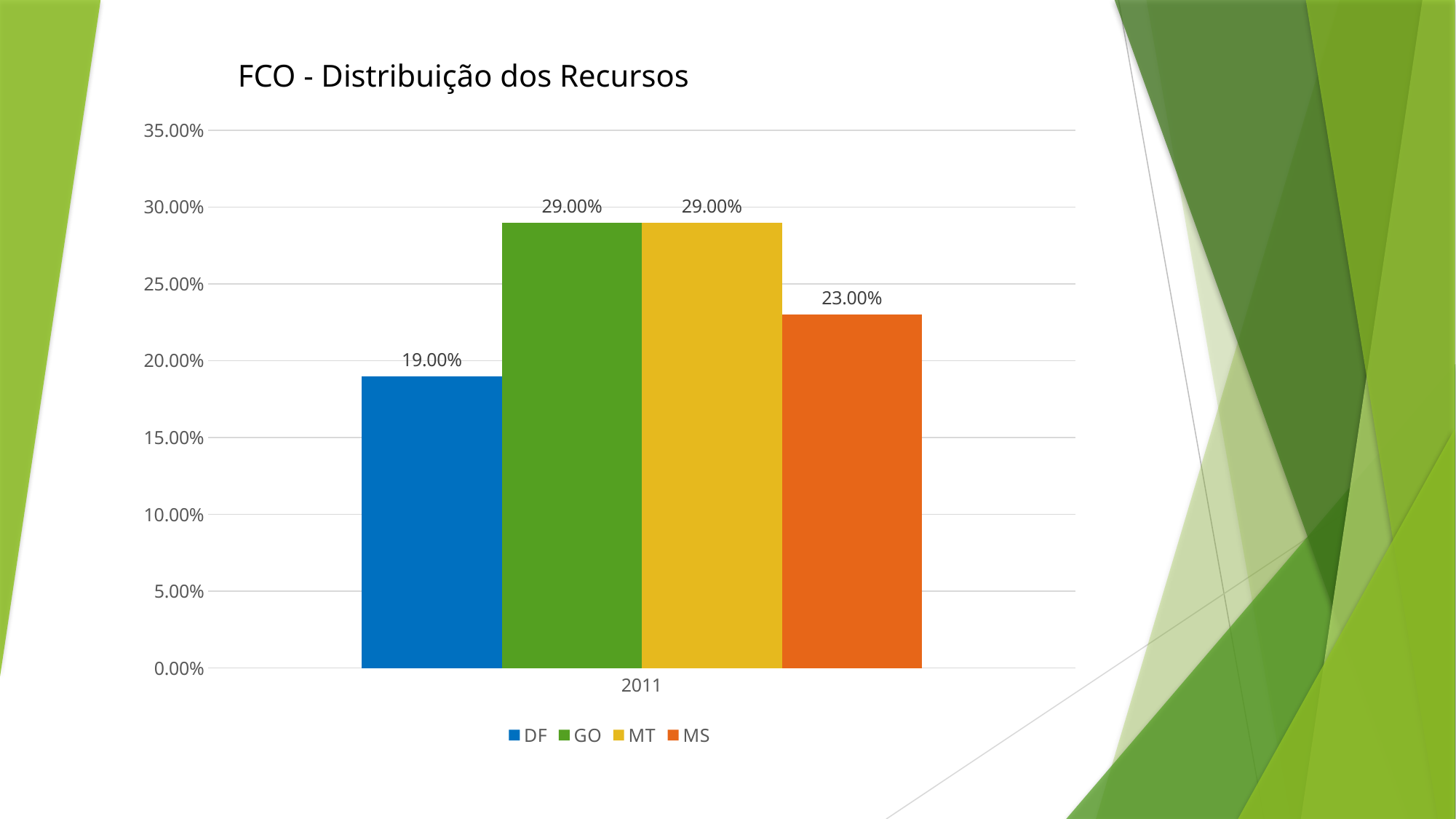
What colour is the bar for MT? yellow How many series does the legend list? 4 What is the difference between the values for MS and DF? 4.00% What is the value for MS in 2011? 23.00% What is the value for GO in 2011? 29.00% What is the difference between the values for GO and MS? 6.00% Which is larger, the value for MT or the value for MS? MT What is the title of the chart? FCO - Distribuição dos Recursos Which series has the lowest value in 2011? DF What is the value for DF in 2011? 19.00% What kind of chart is shown on the slide? bar chart Is the value for DF greater or less than 20.00%? less